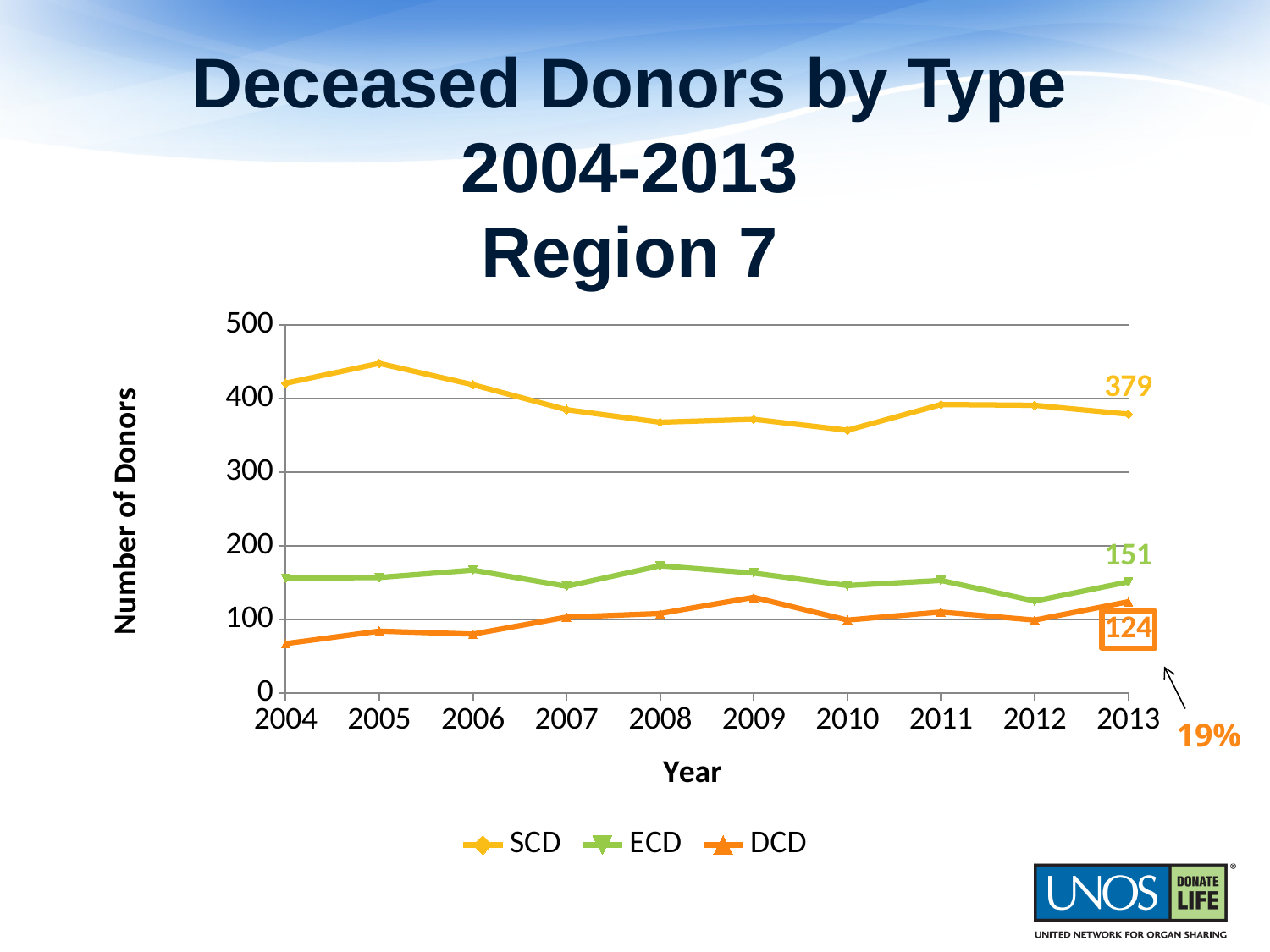
What is the number of ECD donors in 2013? 151 What is the number of SCD donors in 2013? 379 What is the difference between the SCD and ECD values in 2013? 228 What type of chart is shown on the slide? line chart What is the number of DCD donors in 2013? 124 Which donor type has the highest value in 2013? SCD How many series does the legend list? 3 How many years are plotted along the x axis? 10 Is the value for DCD in 2004 greater or less than 100? less Is the value for SCD in 2005 greater or less than 400? greater Does the SCD line rise or fall from 2005 to 2010? fall In which year is the SCD line at its highest? 2005